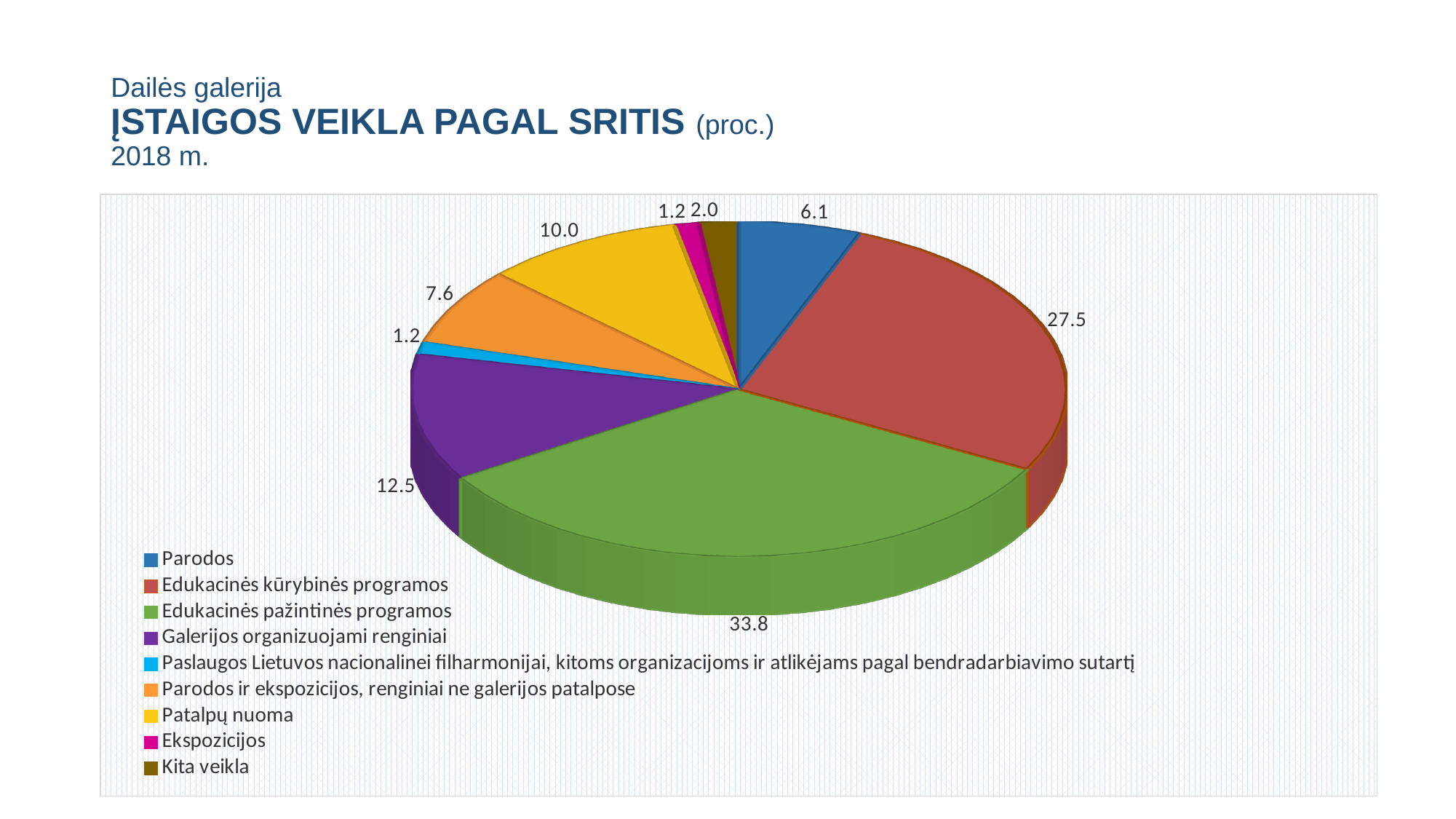
What is the value for Edukacinės kūrybinės programos? 27.5 What is the value for Kita veikla? 2.0 What year does the chart title refer to? 2018 m. What is the value for Galerijos organizuojami renginiai? 12.5 What is the value for Patalpų nuoma? 10.0 What kind of chart is shown on the slide? Pie chart Which is larger, the value for Patalpų nuoma or the value for Parodos ir ekspozicijos, renginiai ne galerijos patalpose? Patalpų nuoma What is the difference between the values for Galerijos organizuojami renginiai and Parodos? 6.4 What is the difference between the values for Edukacinės pažintinės programos and Edukacinės kūrybinės programos? 6.3 Which category has the largest slice of the pie? Edukacinės pažintinės programos What is the value for Parodos? 6.1 How many categories does the legend list? 9